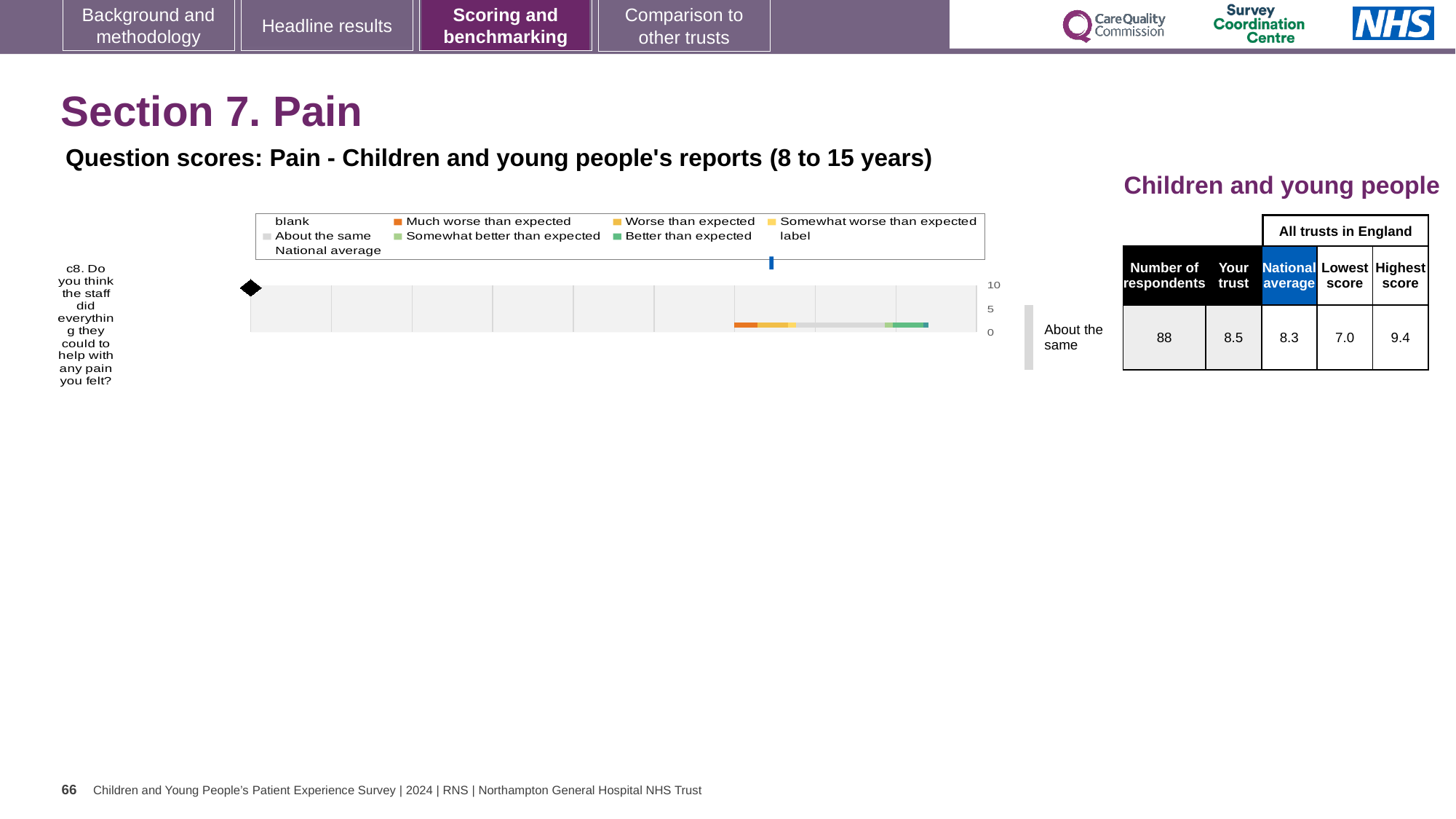
What is the 'Your trust' score for question c8? 8.5 Which is larger for question c8, the 'Your trust' score or the national average? Your trust What is the highest value shown on the chart's axis? 10 Which survey question is plotted on the chart? c8. Do you think the staff did everything they could to help with any pain you felt? What is the lowest score among all trusts in England for question c8? 7.0 What kind of chart is shown on the slide? bar chart Is the 'Your trust' score for question c8 greater or less than 5? greater What is the national average score for question c8? 8.3 What is the highest score among all trusts in England for question c8? 9.4 How many survey questions (categories) are plotted on the chart? 1 How many respondents answered question c8? 88 What is the difference between the highest score and the lowest score for question c8? 2.4